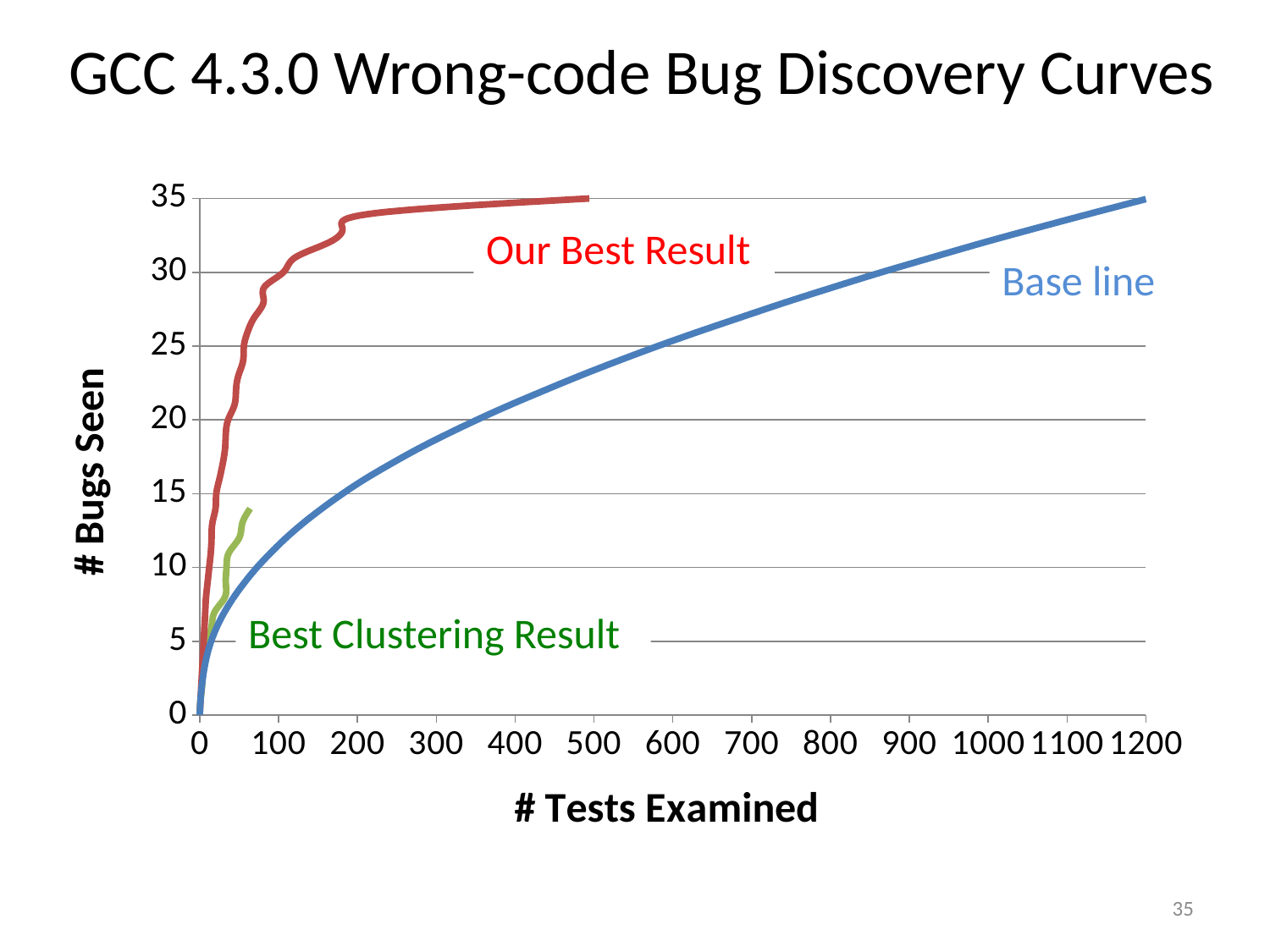
Is the number of bugs seen for Our Best Result at 100 tests examined greater or less than 25? greater What kind of chart is shown on the slide? line chart Is the number of bugs seen for Base line at 300 tests examined greater or less than 20? less What is the label of the x axis? # Tests Examined Which curve reaches 35 bugs seen with the fewest tests examined? Our Best Result Is the number of bugs seen for Base line at 800 tests examined greater or less than 25? greater Which curve is drawn in green? Best Clustering Result How many curves are plotted on the chart? 3 Does the Base line curve rise or fall as the number of tests examined increases? rise At 100 tests examined, which curve shows more bugs seen: Our Best Result or Base line? Our Best Result What is the title of the chart? GCC 4.3.0 Wrong-code Bug Discovery Curves